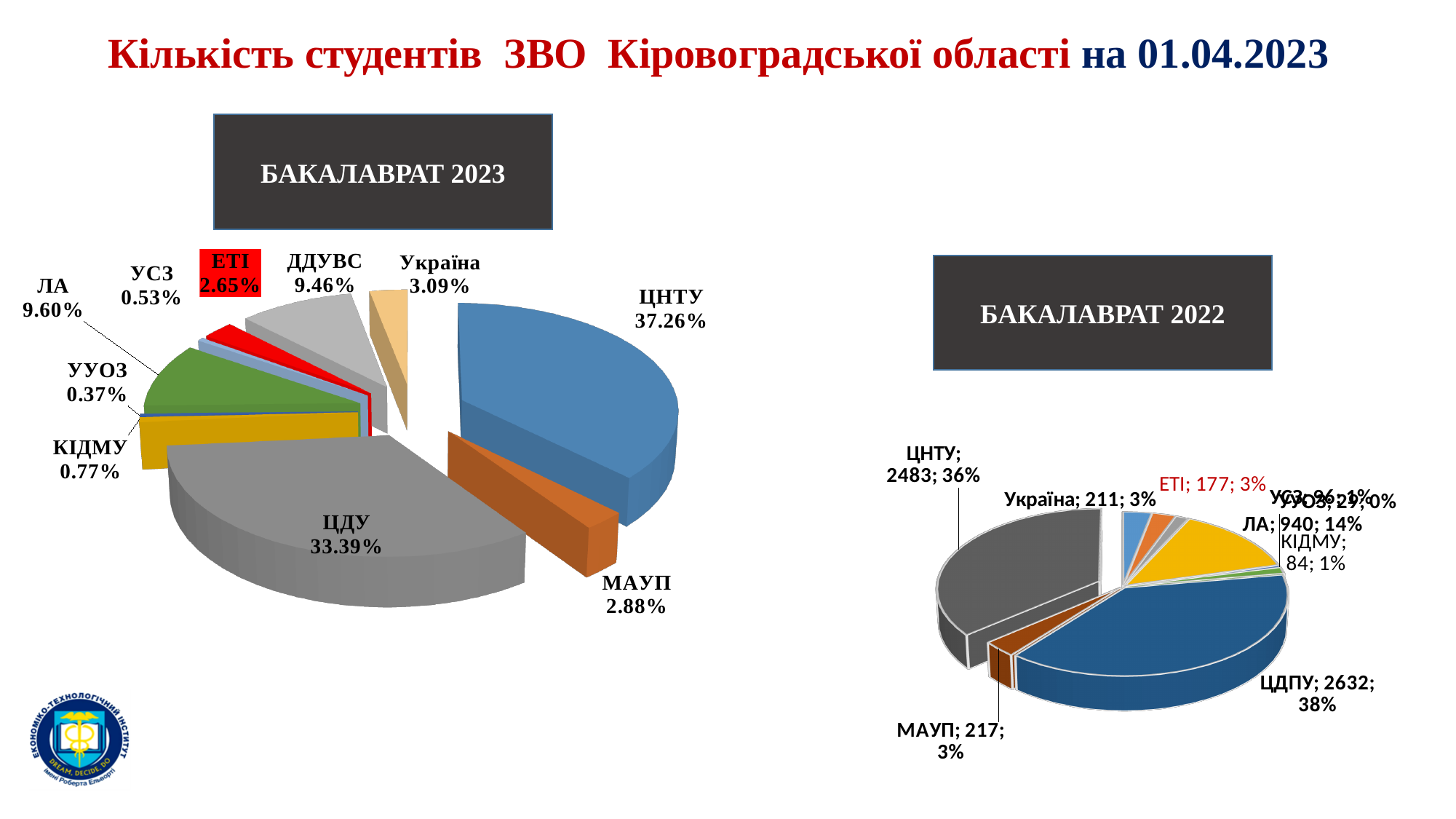
In the БАКАЛАВРАТ 2022 chart, how many students does ЦДПУ have? 2632 In the БАКАЛАВРАТ 2023 chart, what is the difference between the shares of ЦНТУ and ЦДУ? 3.87% How many categories are shown in the БАКАЛАВРАТ 2023 chart? 10 In the БАКАЛАВРАТ 2023 chart, which category has the largest share? ЦНТУ In the БАКАЛАВРАТ 2022 chart, how many students does ЛА have? 940 In the БАКАЛАВРАТ 2023 chart, which is larger, the share of ЛА or the share of ДДУВС? ЛА In the БАКАЛАВРАТ 2023 chart, what share does ЦНТУ have? 37.26% What kind of chart is the БАКАЛАВРАТ 2022 chart? Pie chart In the БАКАЛАВРАТ 2023 chart, what share does ЕТІ have? 2.65% In the БАКАЛАВРАТ 2023 chart, which category has the smallest share? УУОЗ In the БАКАЛАВРАТ 2022 chart, what is the difference between the student counts of ЦДПУ and ЦНТУ? 149 In the БАКАЛАВРАТ 2023 chart, what share does ЦДУ have? 33.39%